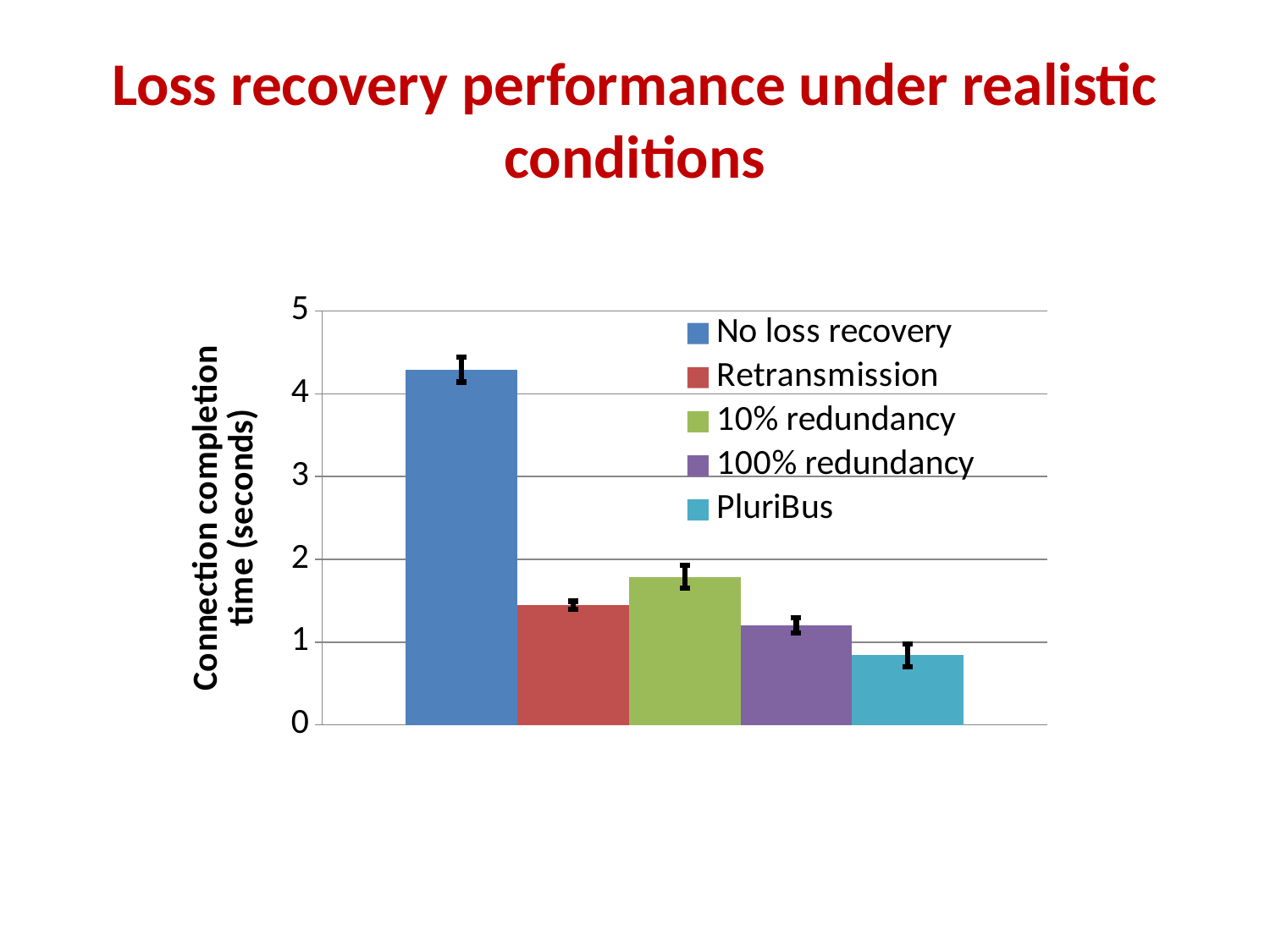
What is the title of the slide? Loss recovery performance under realistic conditions Which has a higher connection completion time, 10% redundancy or Retransmission? 10% redundancy Is the value for No loss recovery greater or less than 4? greater Which series has the highest connection completion time? No loss recovery What kind of chart is shown on the slide? bar chart Is the value for Retransmission greater or less than 1? greater Which has a lower connection completion time, 100% redundancy or Retransmission? 100% redundancy What is the label of the vertical axis? Connection completion time (seconds) Is the value for PluriBus greater or less than 1? less Which series has the lowest connection completion time? PluriBus How many series does the legend list? 5